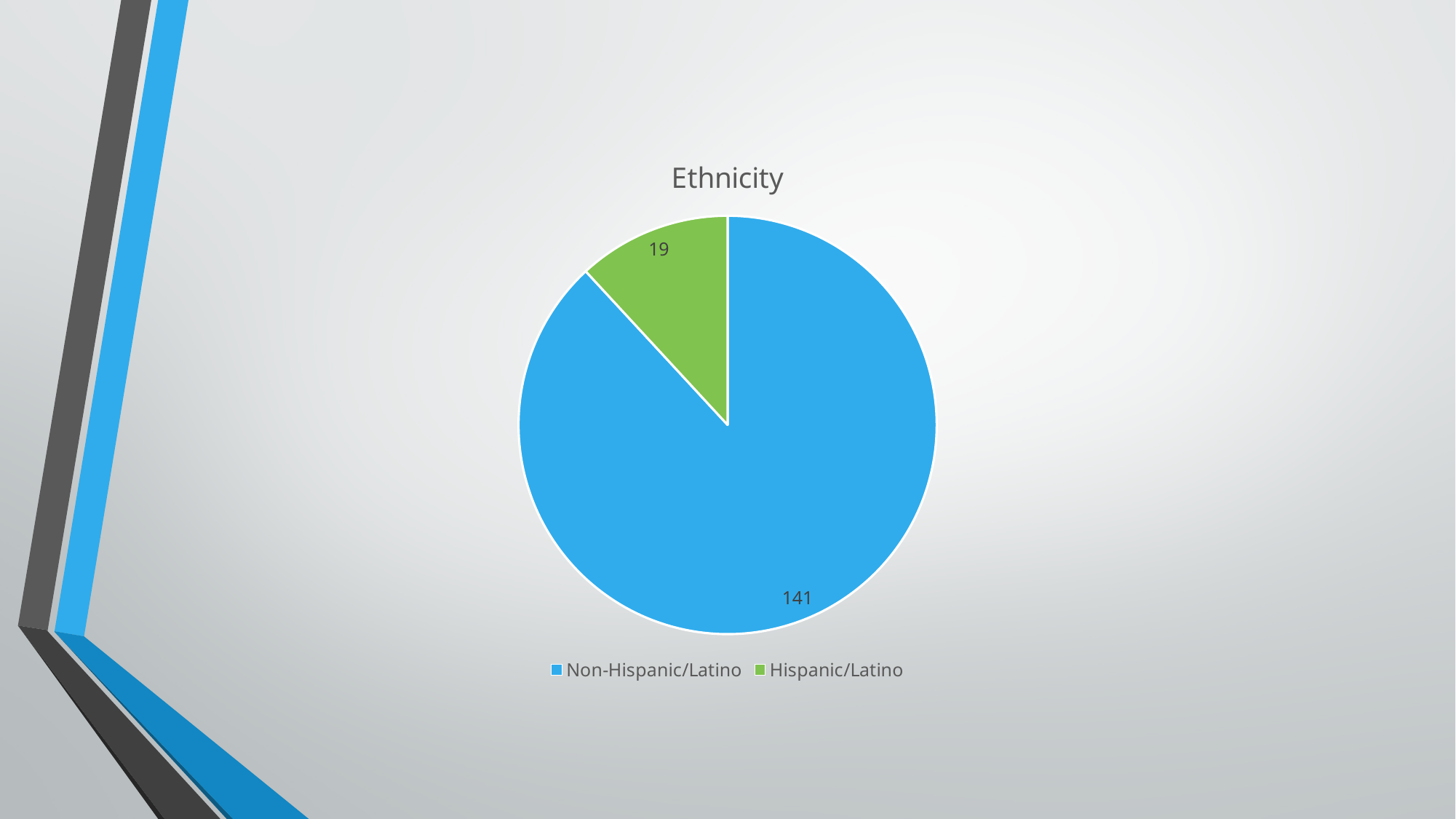
What colour is the Hispanic/Latino slice in the Ethnicity pie chart? Green Which category has the largest slice in the Ethnicity pie chart? Non-Hispanic/Latino What is the difference between the Non-Hispanic/Latino and Hispanic/Latino values in the Ethnicity pie chart? 122 What is the title of the chart on the slide? Ethnicity What is the value for Hispanic/Latino in the Ethnicity pie chart? 19 What kind of chart is shown on the slide? Pie chart What is the total of the two slices in the Ethnicity pie chart? 160 How many categories are shown in the Ethnicity pie chart? 2 Which category has the smallest slice in the Ethnicity pie chart? Hispanic/Latino Which is larger in the Ethnicity pie chart, Non-Hispanic/Latino or Hispanic/Latino? Non-Hispanic/Latino What is the value for Non-Hispanic/Latino in the Ethnicity pie chart? 141